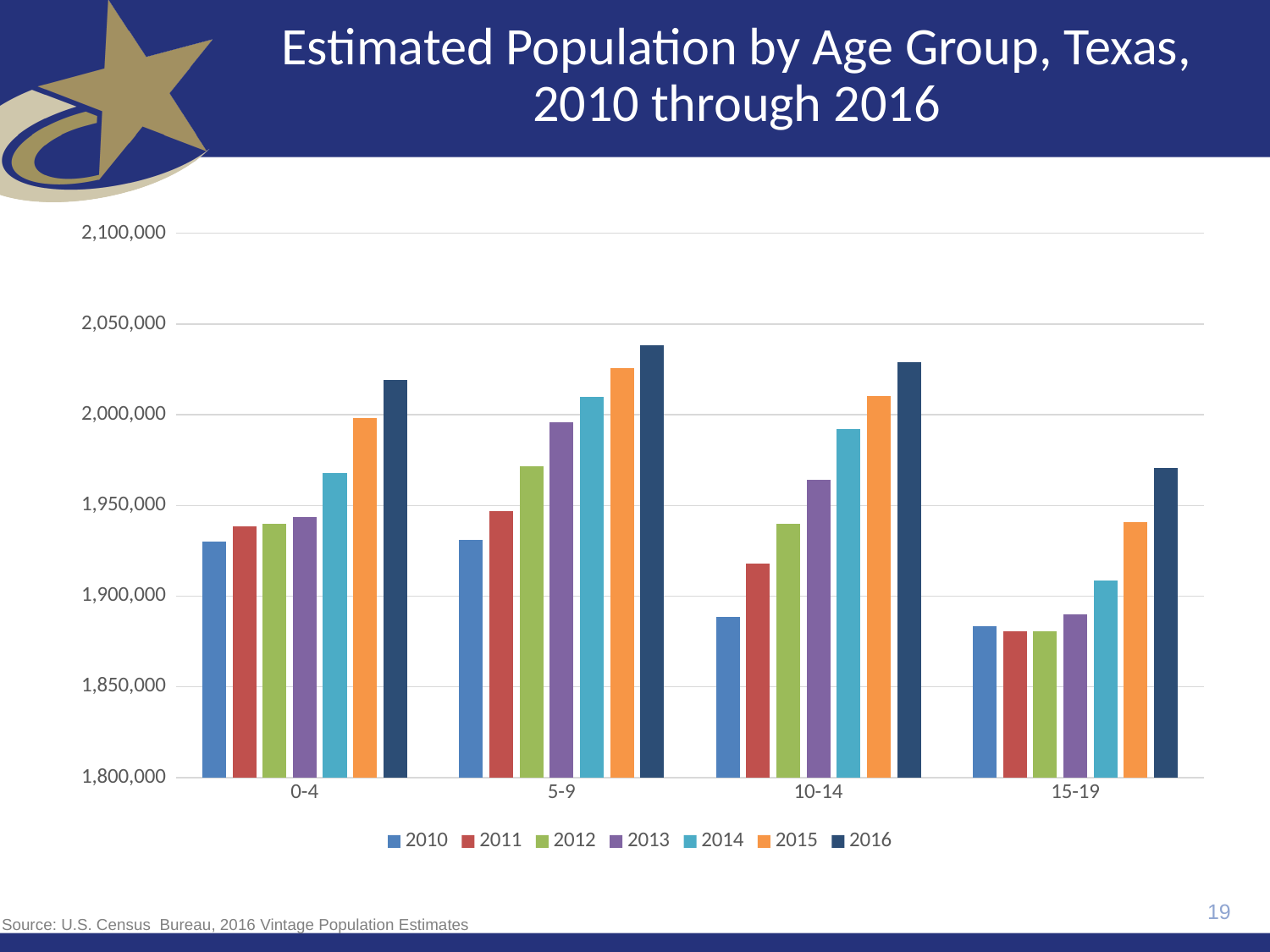
Is the 2016 value for the 15-19 age group greater or less than 1,950,000? greater Is the 2010 value for the 10-14 age group greater or less than 1,900,000? less How many age groups are shown on the x axis? 4 Within the 5-9 age group, do the values rise or fall from 2010 to 2016? rise Is the 2012 value for the 15-19 age group greater or less than 1,900,000? less Which is larger: the 2016 value for the 0-4 age group or the 2016 value for the 5-9 age group? 5-9 Which year has the lowest bar within the 10-14 age group? 2010 What kind of chart is shown on the slide? Bar chart How many series (years) does the legend list? 7 Which year has the highest bar within the 15-19 age group? 2016 Which age group has the tallest 2016 bar? 5-9